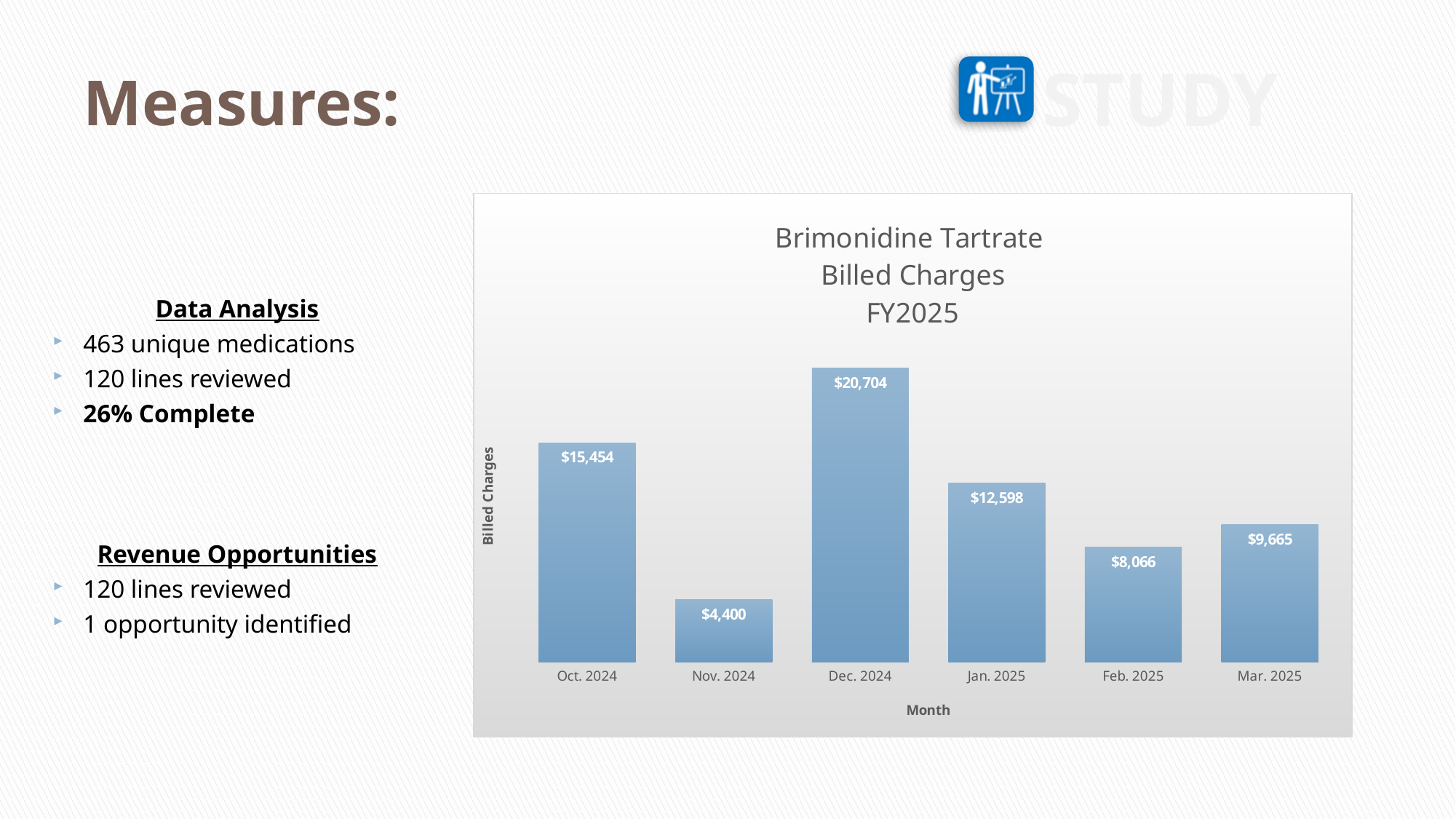
What is the difference in billed charges between Oct. 2024 and Nov. 2024? $11,054 What is the billed charges value for Mar. 2025? $9,665 Which month has the lowest billed charges? Nov. 2024 What is the difference in billed charges between Dec. 2024 and Jan. 2025? $8,106 Do the billed charges rise or fall from Dec. 2024 to Feb. 2025? Fall What is the billed charges value for Nov. 2024? $4,400 Which month has the highest billed charges? Dec. 2024 What kind of chart is shown on the slide? Bar chart How many months are shown on the chart? 6 Which month has higher billed charges, Feb. 2025 or Mar. 2025? Mar. 2025 What is the billed charges value for Dec. 2024? $20,704 What is the title of the chart? Brimonidine Tartrate Billed Charges FY2025